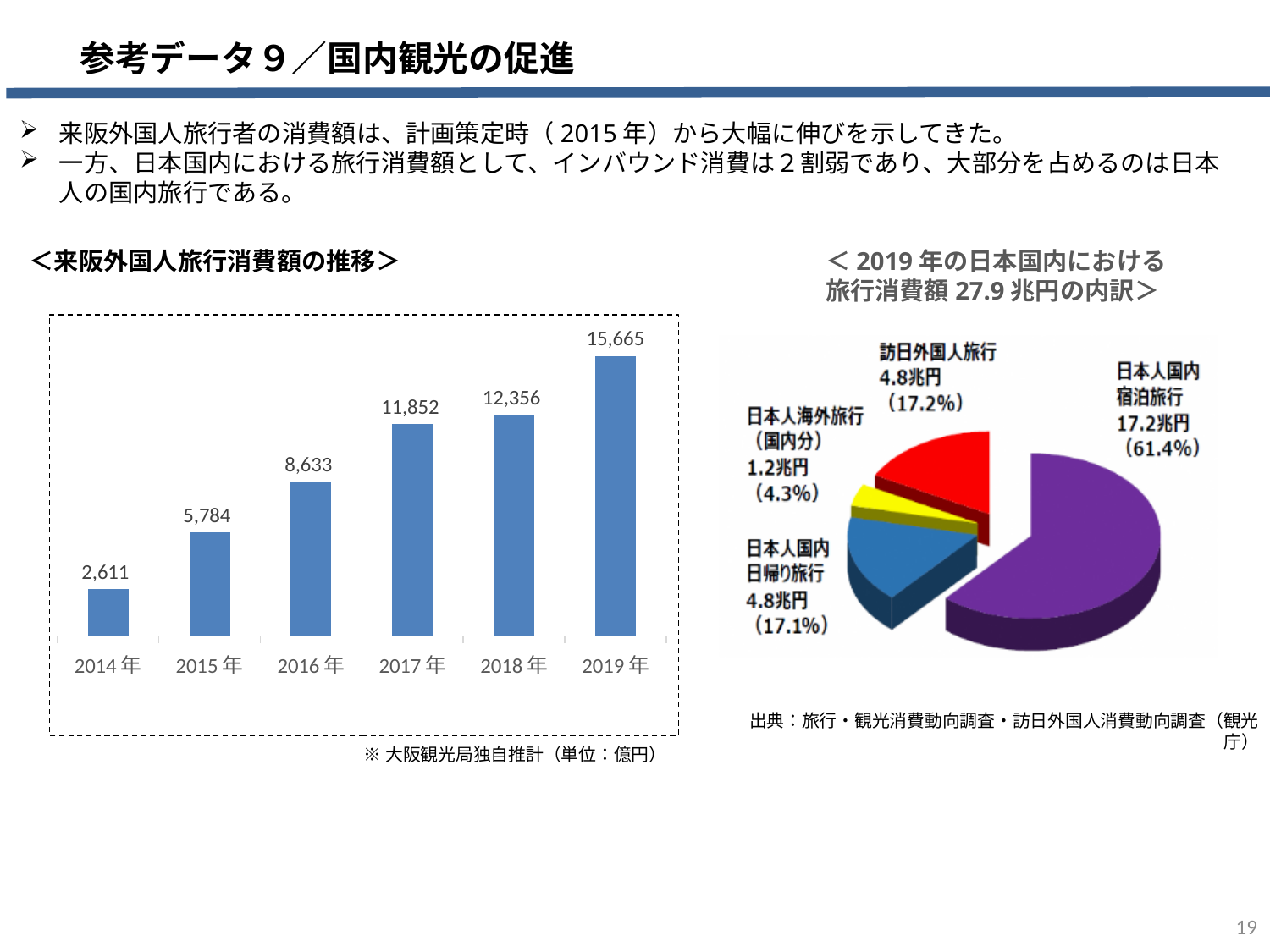
In the pie chart on the right, how many slices are there? 4 In the bar chart titled 来阪外国人旅行消費額の推移, how many years are shown on the x axis? 6 In the bar chart titled 来阪外国人旅行消費額の推移, what is the value for 2019年? 15,665 What kind of chart is the one on the left titled 来阪外国人旅行消費額の推移? bar chart In the bar chart titled 来阪外国人旅行消費額の推移, what is the difference between the values for 2019年 and 2014年? 13,054 In the bar chart titled 来阪外国人旅行消費額の推移, which year has the highest value? 2019年 In the bar chart titled 来阪外国人旅行消費額の推移, what is the value for 2016年? 8,633 In the bar chart titled 来阪外国人旅行消費額の推移, which year has the lowest value? 2014年 In the pie chart on the right, what is the value for 訪日外国人旅行? 4.8兆円 In the bar chart titled 来阪外国人旅行消費額の推移, do the values rise or fall from 2014年 to 2019年? rise In the pie chart on the right, what share does 日本人国内宿泊旅行 have? 61.4% In the pie chart on the right, which category has the smallest slice? 日本人海外旅行（国内分）